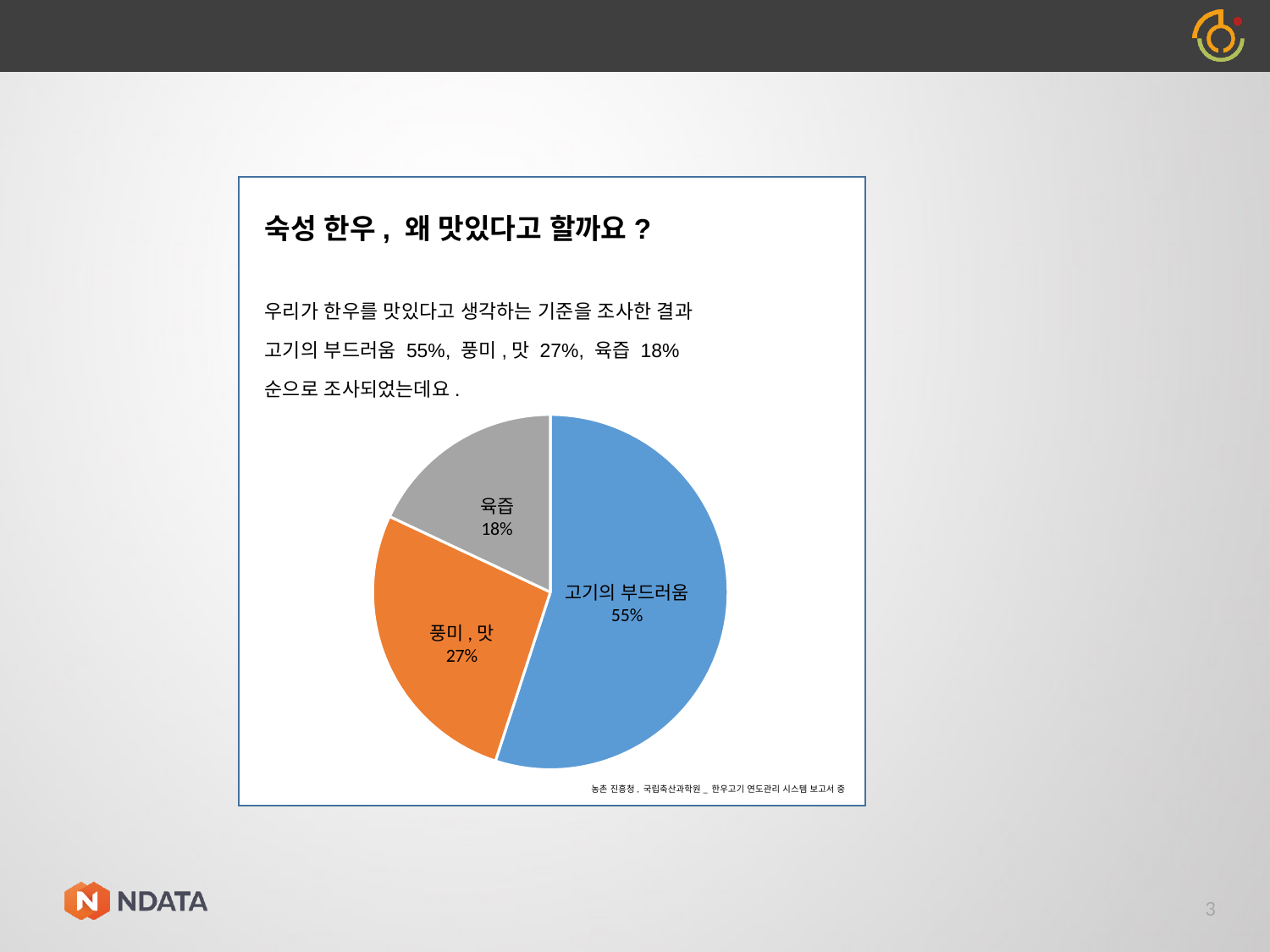
What share of the pie does 풍미 , 맛 represent? 27% Which is larger, the share for 풍미 , 맛 or the share for 육즙? 풍미 , 맛 How many slices does the pie chart have? 3 What share of the pie does 육즙 represent? 18% Which slice of the pie chart is the largest? 고기의 부드러움 What share of the pie does 고기의 부드러움 represent? 55% What type of chart is shown on the slide? pie chart Which slice of the pie chart is the smallest? 육즙 What colour is the 고기의 부드러움 slice? blue What colour is the 육즙 slice? grey What is the difference in percentage points between 풍미 , 맛 and 육즙? 9 What is the difference in percentage points between 고기의 부드러움 and 풍미 , 맛? 28